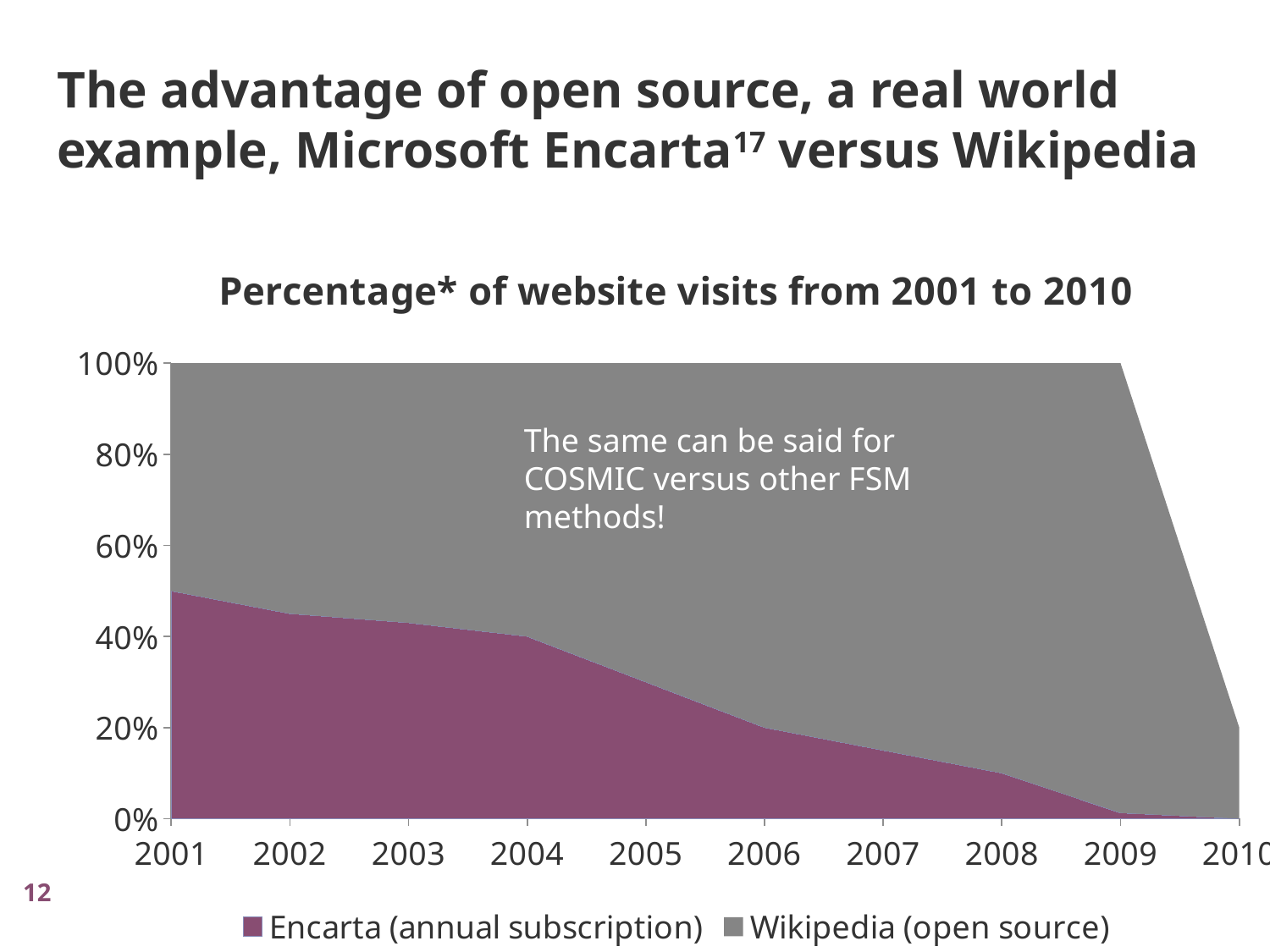
Is the Encarta (annual subscription) value for 2006 greater or less than 40%? less Is the Encarta (annual subscription) value for 2004 greater or less than 20%? greater How many years are shown along the x axis? 10 Does the Encarta (annual subscription) share rise or fall from 2001 to 2010? Fall How many series does the chart legend list? 2 Is the Encarta (annual subscription) value for 2001 greater or less than 40%? greater What is the title of the chart? Percentage* of website visits from 2001 to 2010 In which year is the Encarta (annual subscription) share highest? 2001 What kind of chart is shown on the slide? Area chart Which is larger, the Encarta (annual subscription) share in 2001 or in 2007? 2001 What are the two series named in the legend? Encarta (annual subscription) and Wikipedia (open source)